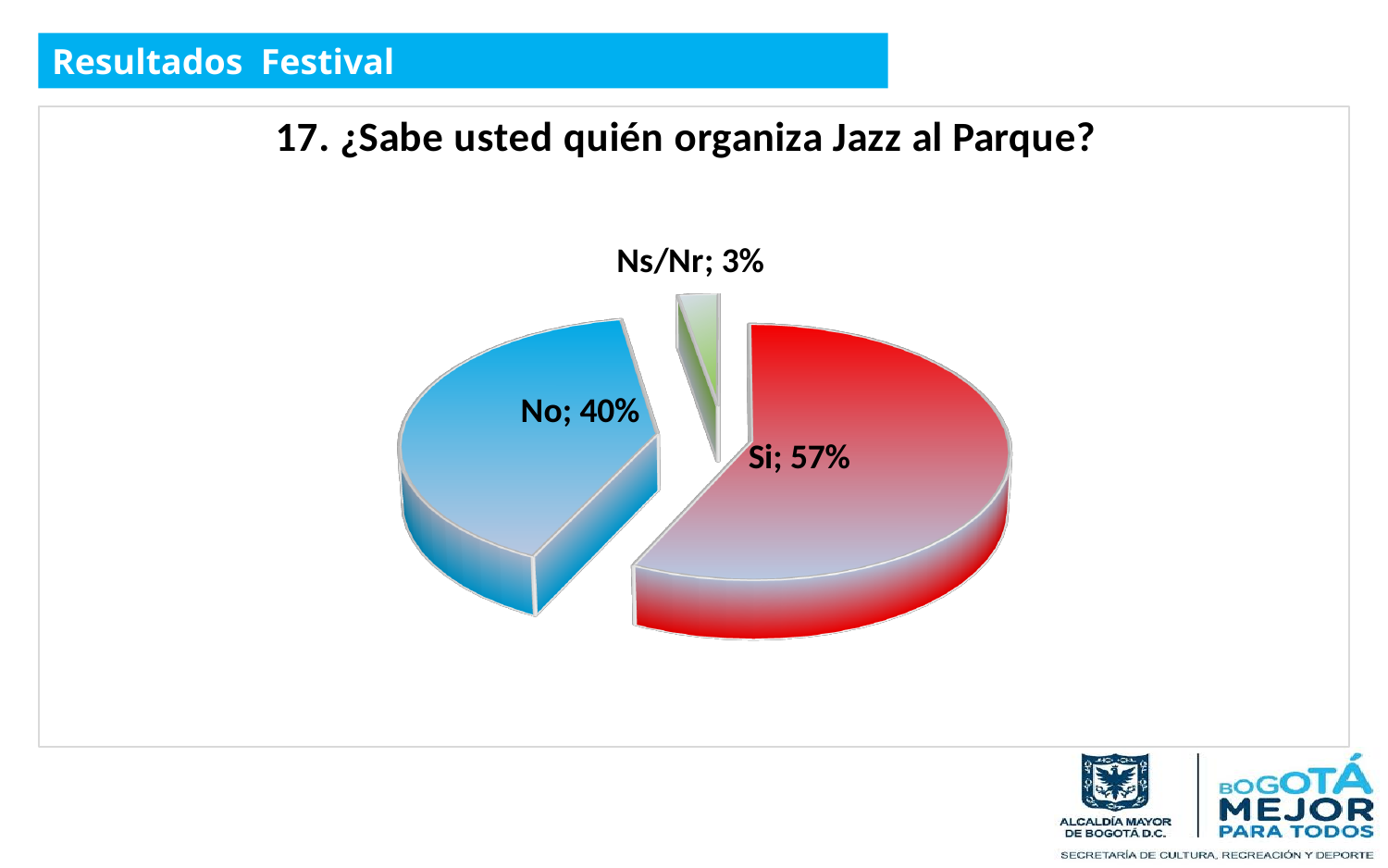
How many slices does the pie chart have? 3 What is the difference in percentage points between the "No" and "Ns/Nr" slices? 37 What percentage of respondents answered "Ns/Nr"? 3% Which is larger, the "No" slice or the "Ns/Nr" slice? No What is the difference in percentage points between the "Si" and "No" slices? 17 What colour is the "Si" slice? red Which response has the largest share of the pie? Si What percentage of respondents answered "Si"? 57% What type of chart is shown on the slide? pie chart What is the title of the chart? 17. ¿Sabe usted quién organiza Jazz al Parque? What percentage of respondents answered "No"? 40% Which response has the smallest share of the pie? Ns/Nr